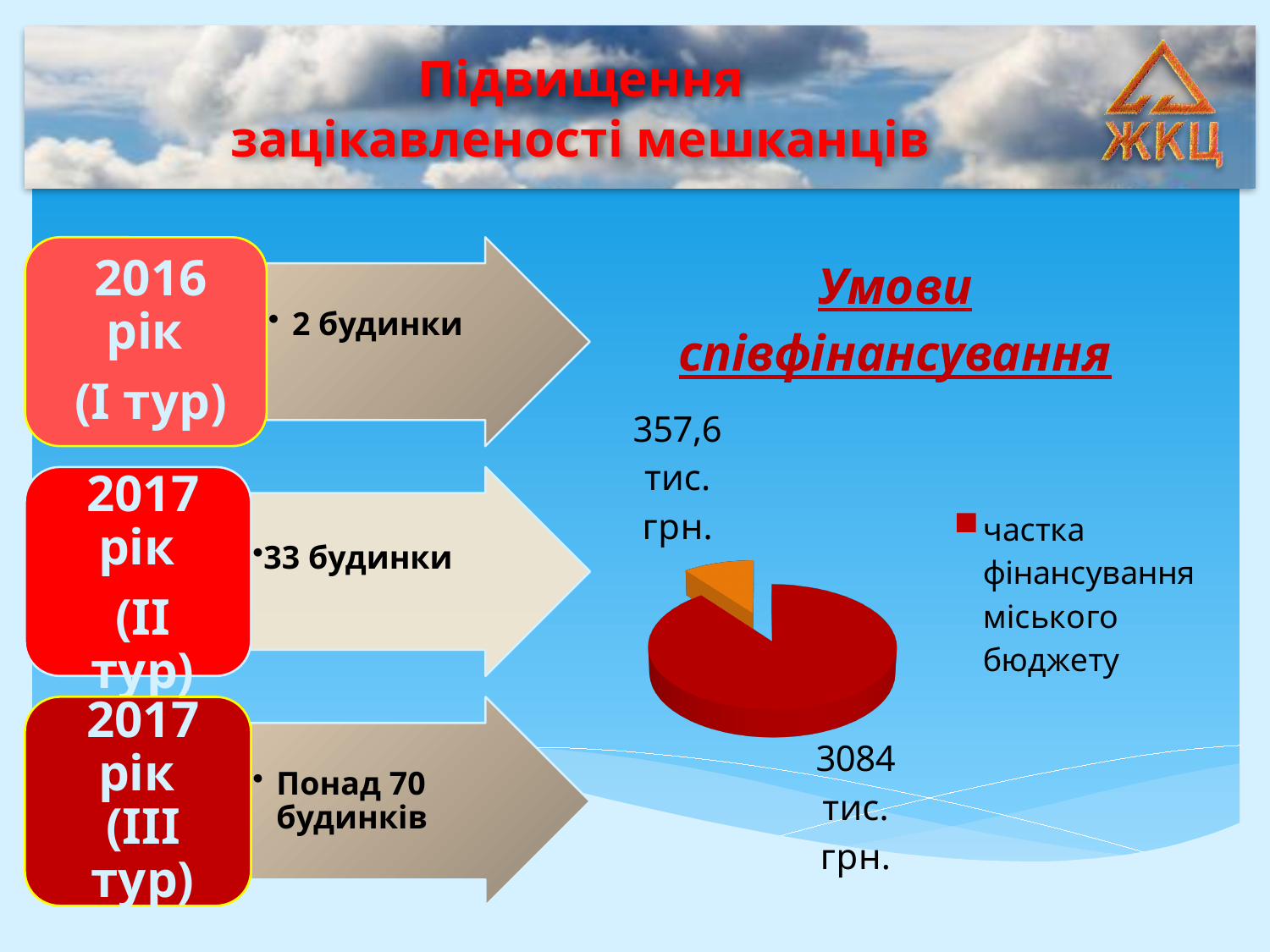
What share of the pie does the slice "частка фінансування міського бюджету" represent, to the nearest whole percent? 90% How many entries does the legend of the pie chart list? 1 Which slice of the pie chart is the largest? частка фінансування міського бюджету What is the value of the slice labelled "частка фінансування міського бюджету" in the pie chart? 3084 тис. грн. Which is larger in the pie chart: the red slice or the orange slice? the red slice What is the title of the chart on the slide? Умови співфінансування How many slices does the pie chart have? 2 What is the difference between the two slice values in the pie chart (3084 and 357,6 тис. грн.)? 2726,4 тис. грн. What colour is the slice labelled "частка фінансування міського бюджету" in the pie chart? red What kind of chart is shown on the slide under the heading "Умови співфінансування"? pie chart What is the total of the two slice values shown in the pie chart? 3441,6 тис. грн. What is the value of the smaller (orange) slice of the pie chart? 357,6 тис. грн.